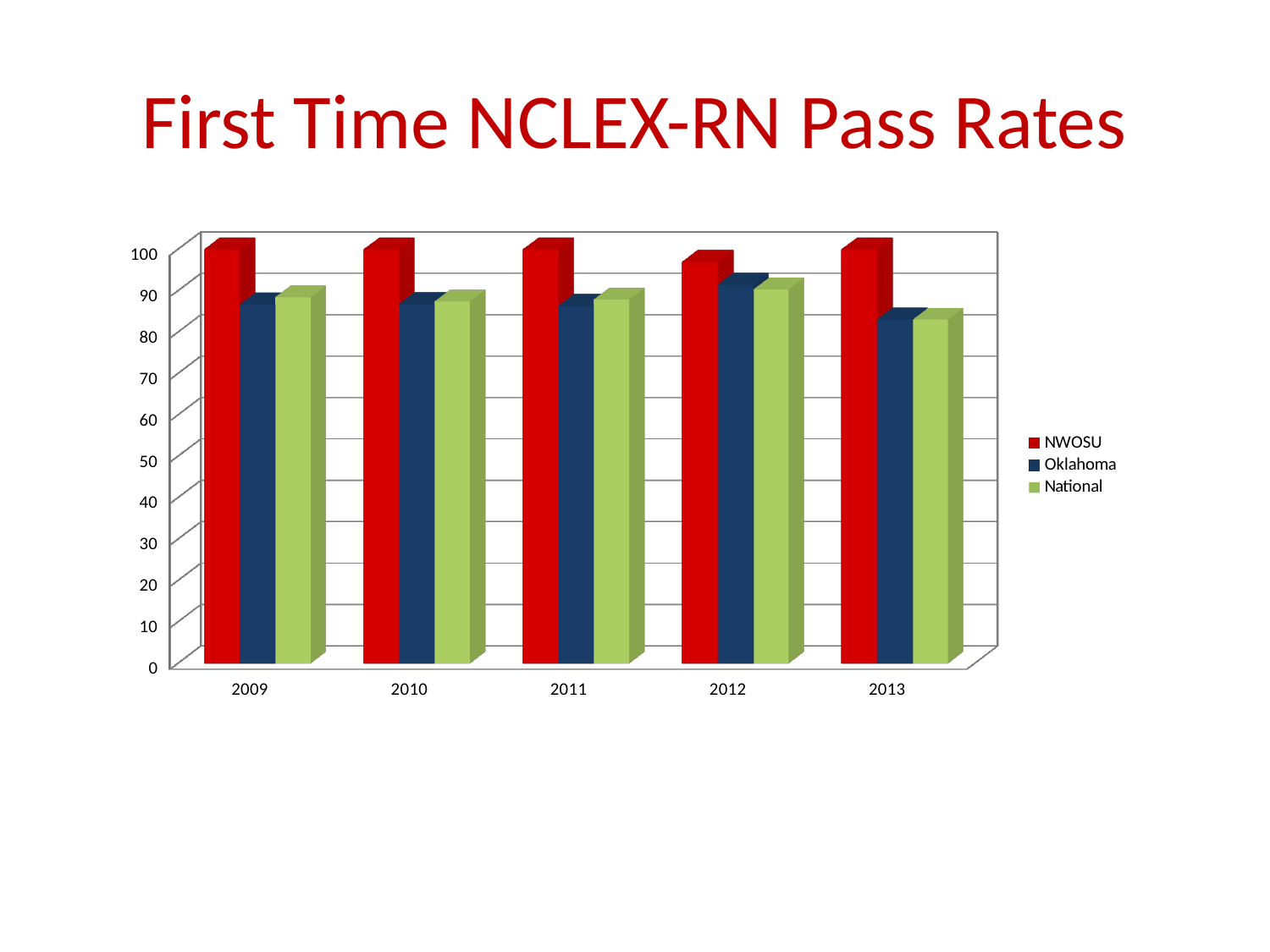
What is the title of the chart? First Time NCLEX-RN Pass Rates Is the Oklahoma value for 2013 greater or less than 90? less In which year is the Oklahoma value lowest? 2013 Is the NWOSU value for 2012 greater or less than 90? greater How many series does the legend list? 3 Which series is shown in red? NWOSU In which year is the NWOSU value lowest? 2012 How many years are shown on the x axis? 5 In 2013, which is larger, the NWOSU value or the Oklahoma value? NWOSU In which year is the National value lowest? 2013 In which year is the Oklahoma value highest? 2012 What kind of chart is shown on the slide? Bar chart